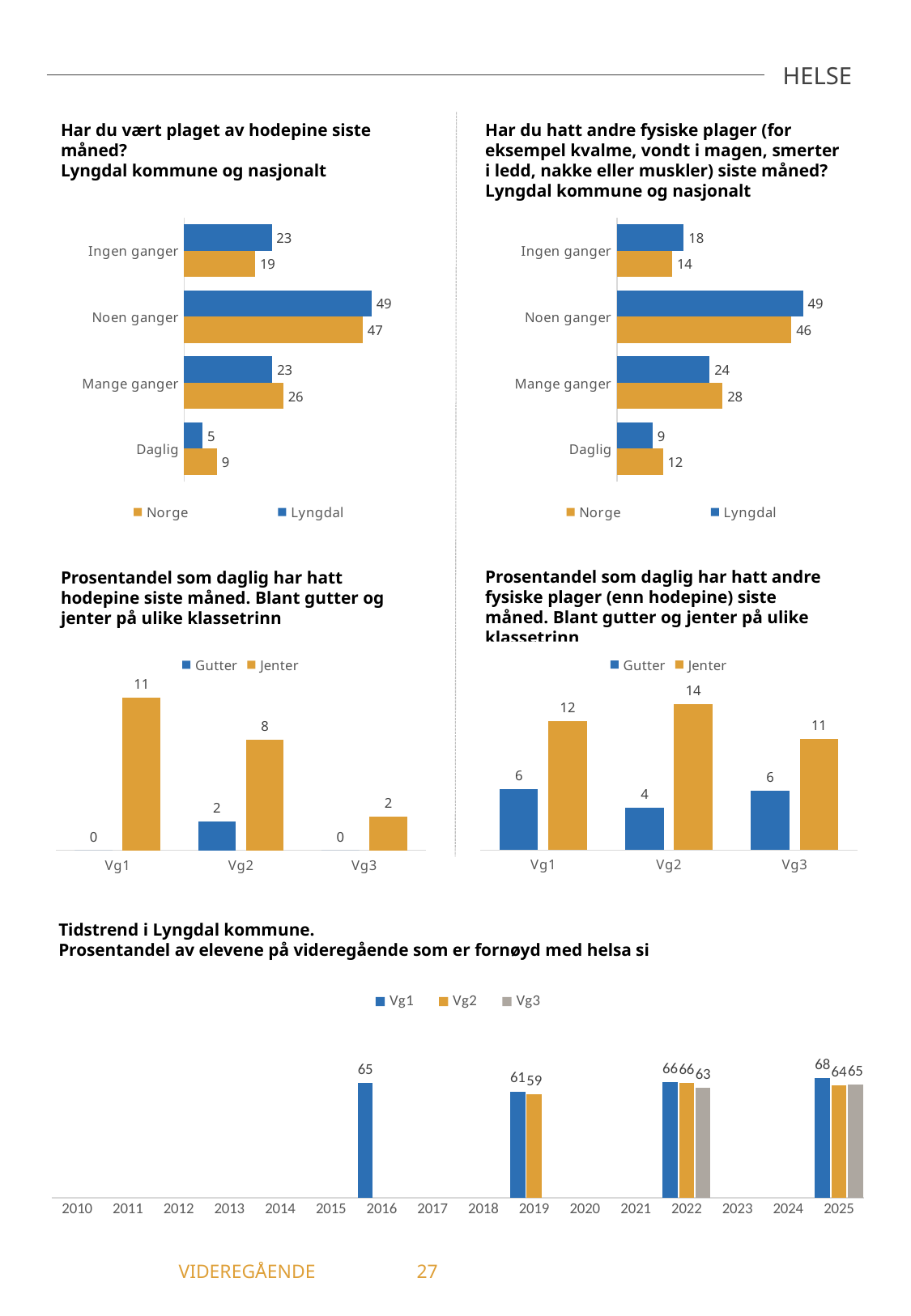
In the top-left chart about headaches (hodepine), what is the difference between the Norge and Lyngdal values for 'Daglig'? 4 In the top-right chart about other physical complaints (andre fysiske plager), how many series does the legend list? 2 In the top-left chart about headaches (hodepine), what is the value for Lyngdal in the 'Noen ganger' category? 49 In the top-right chart about other physical complaints (andre fysiske plager), which is larger for 'Ingen ganger': Norge or Lyngdal? Lyngdal In the middle-right chart on daily other physical complaints among boys and girls, which class level has the highest value for Jenter? Vg2 In the middle-left chart on daily headaches among boys and girls, what is the value for Gutter in Vg2? 2 In the middle-right chart on daily other physical complaints among boys and girls, what is the difference between Jenter and Gutter in Vg3? 5 In the top-left chart about headaches (hodepine), which category has the lowest value for Lyngdal? Daglig In the top-right chart about other physical complaints (andre fysiske plager), what is the value for Norge in the 'Mange ganger' category? 28 What kind of chart is the bottom chart 'Tidstrend i Lyngdal kommune'? Bar chart In the middle-left chart on daily headaches among boys and girls, what is the value for Jenter in Vg1? 11 In the bottom chart 'Tidstrend i Lyngdal kommune', what is the value for Vg1 in 2025? 68